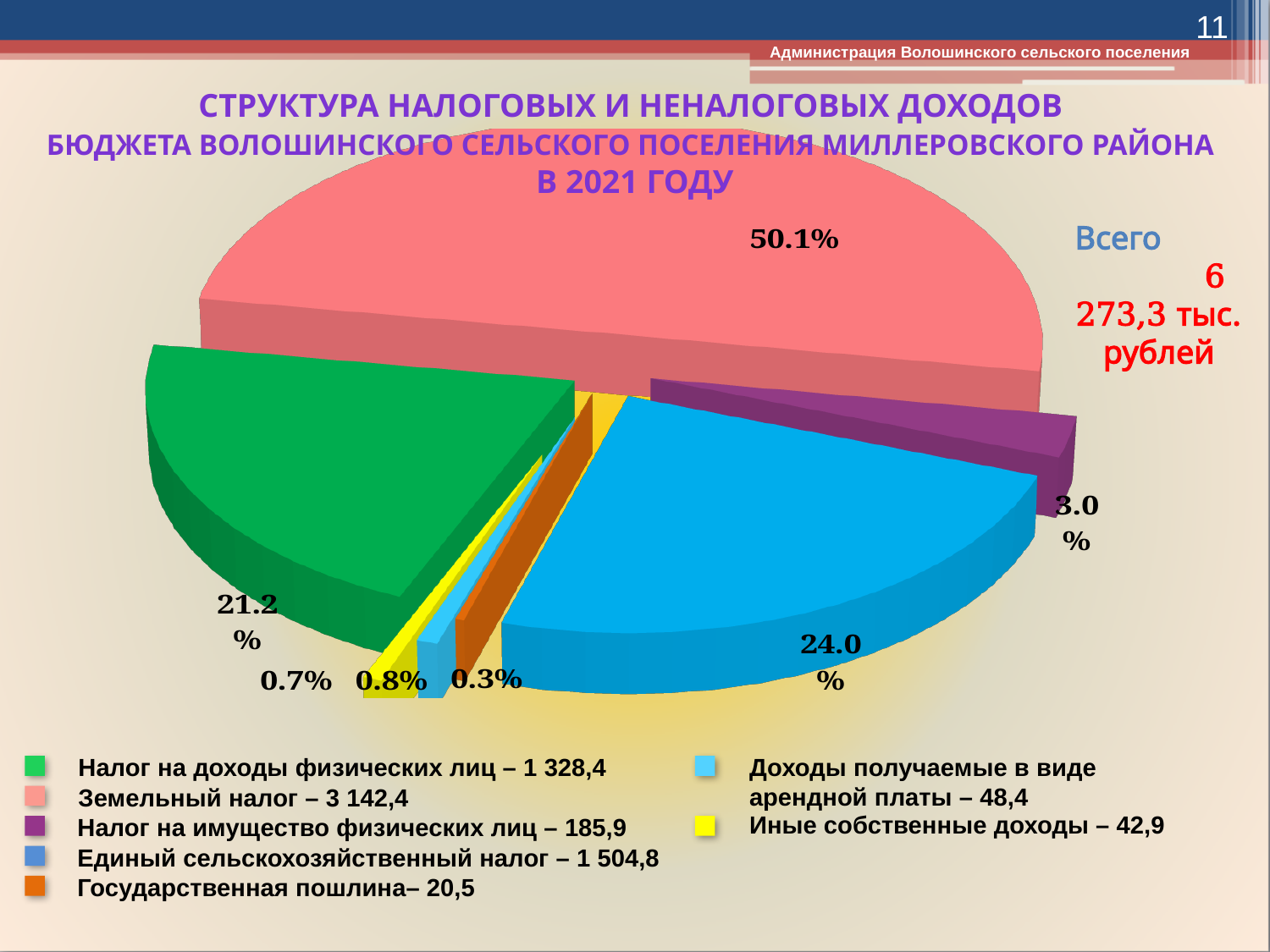
What kind of chart is shown on the slide? pie chart What is the difference in percentage points between the Земельный налог slice (50.1%) and the Единый сельскохозяйственный налог slice (24.0%)? 26.1 How many categories does the legend of the pie chart list? 7 What share of the pie does Земельный налог take? 50.1% What share of the pie does Единый сельскохозяйственный налог take? 24.0% Which is larger: the slice for Налог на доходы физических лиц or the slice for Налог на имущество физических лиц? Налог на доходы физических лиц What total (Всего) is shown next to the pie chart? 6 273,3 тыс. рублей Which category has the smallest slice of the pie? Государственная пошлина What value does the legend give for Иные собственные доходы? 42,9 What value does the legend give for Единый сельскохозяйственный налог? 1 504,8 What share of the pie does Налог на доходы физических лиц take? 21.2% Which category has the largest slice of the pie? Земельный налог